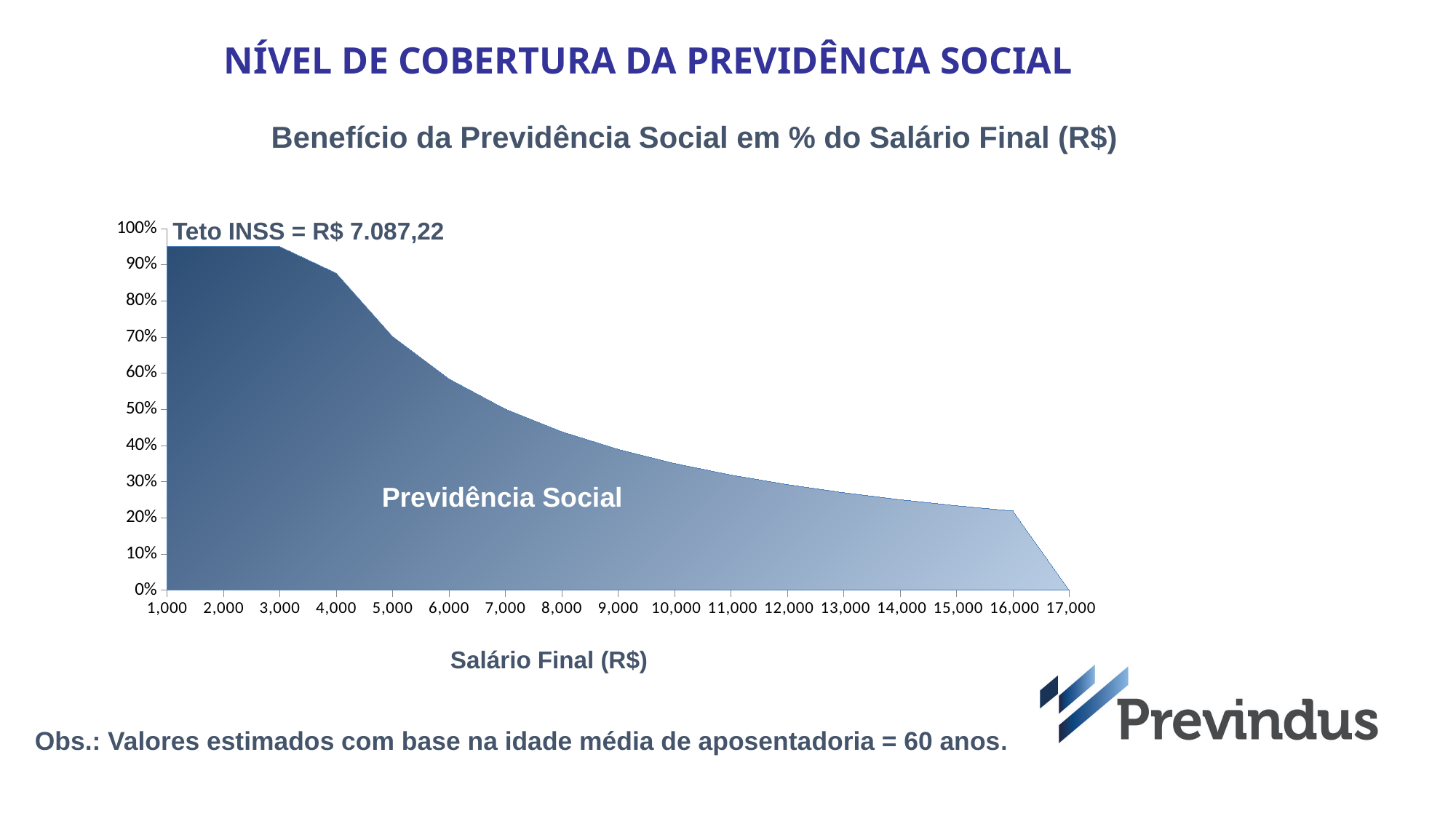
What kind of chart is shown on the slide? Area chart Is the value at a Salário Final of 10,000 greater or less than 40%? less What is the title of the chart? Benefício da Previdência Social em % do Salário Final (R$) Do the values rise or fall as the Salário Final increases along the x axis? Fall Is the value at a Salário Final of 2,000 greater or less than 90%? greater How many Salário Final tick labels are shown on the x axis? 17 Is the value at a Salário Final of 16,000 greater or less than 30%? less What value does the annotation at the top of the chart give for the Teto INSS? R$ 7.087,22 Which has the larger value: a Salário Final of 5,000 or of 10,000? 5,000